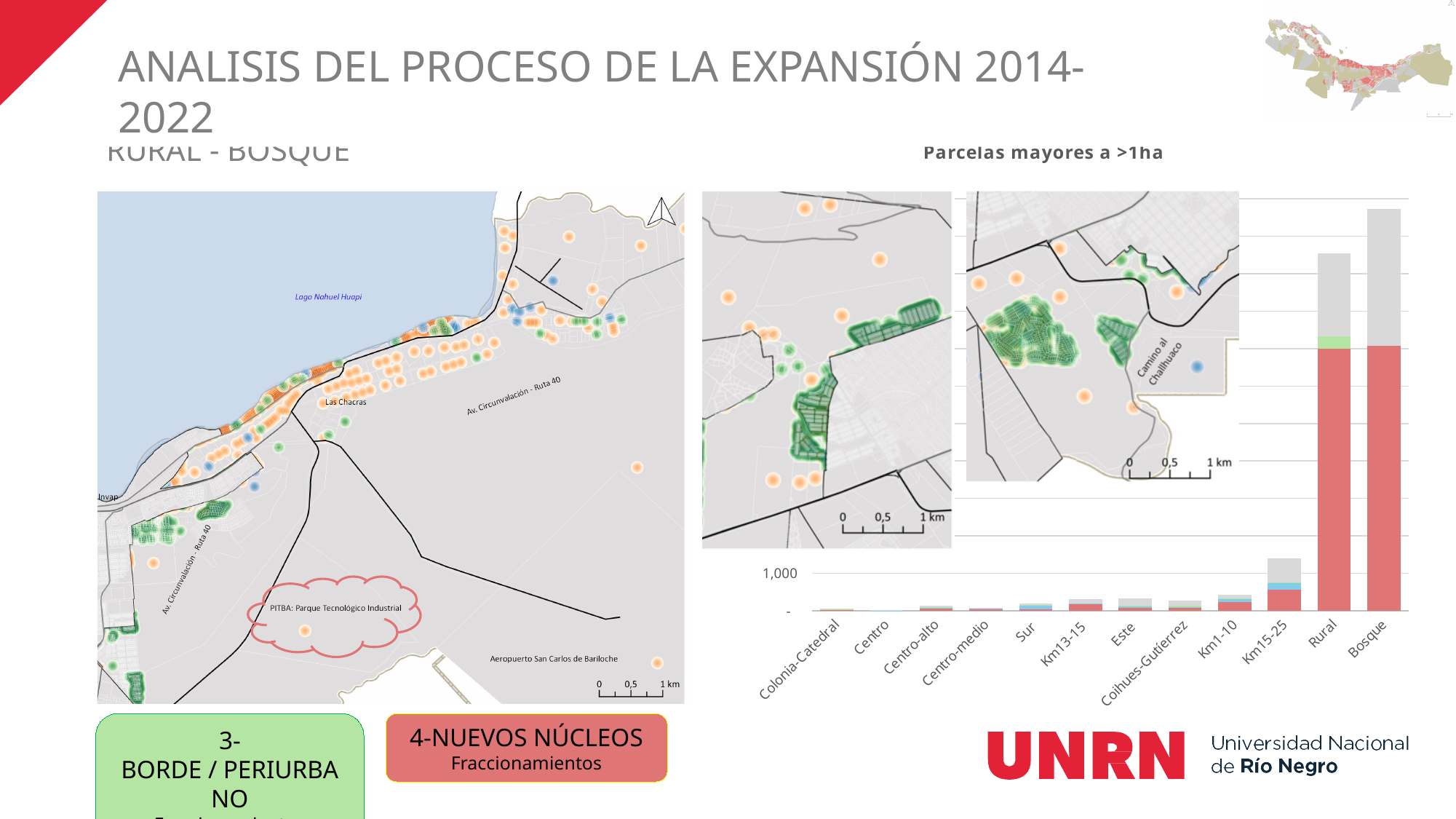
What is the title of the bar chart on the right side of the slide? Parcelas mayores a >1ha In the bar chart, which bar is taller: Bosque or Rural? Bosque In the bar chart, is the total for Bosque greater or less than 1,000? greater Do the bar totals in the bar chart generally rise or fall from left to right along the x axis? rise In the bar chart, is the total for Este greater or less than 1,000? less In the bar chart, which bar is taller: Rural or Km15-25? Rural What kind of chart is shown on the right side of the slide? Stacked bar chart In the bar chart, is the total for Km1-10 greater or less than 1,000? less In the bar chart, which bar is taller: Km13-15 or Centro? Km13-15 How many categories are shown on the x axis of the bar chart? 12 Which category has the tallest bar in the bar chart? Bosque